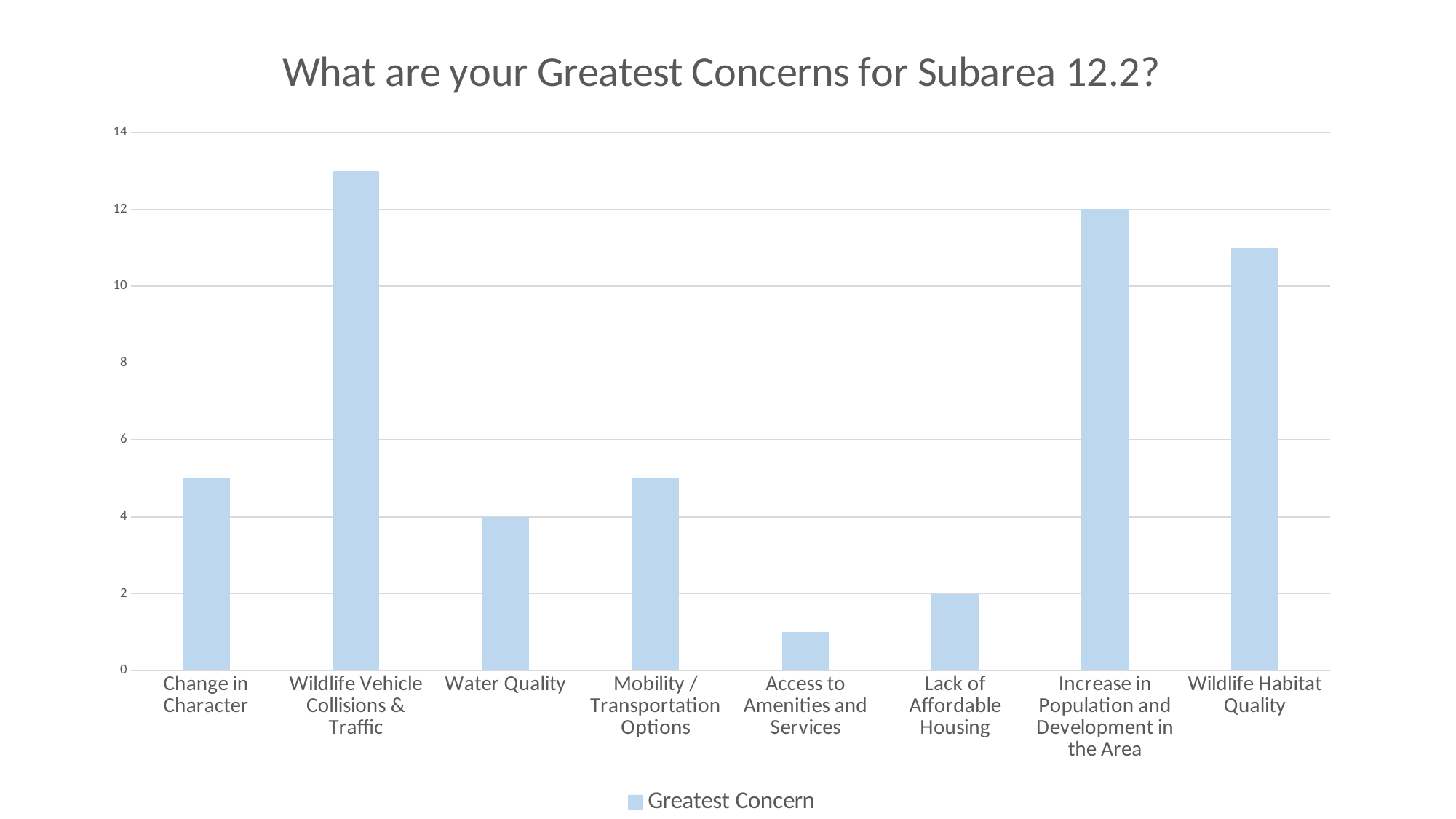
What is the value for Lack of Affordable Housing? 2 How many series does the legend list? 1 What is the title of the chart? What are your Greatest Concerns for Subarea 12.2? What is the name of the series shown in the legend? Greatest Concern Is the value for Wildlife Habitat Quality greater or less than 10? greater Which concern has the lowest bar? Access to Amenities and Services What is the value for Water Quality? 4 What is the difference between the values for Increase in Population and Development in the Area and Lack of Affordable Housing? 10 What is the value for Increase in Population and Development in the Area? 12 How many concern categories are shown on the x axis? 8 What kind of chart is shown on the slide? bar chart Which concern has the highest bar? Wildlife Vehicle Collisions & Traffic